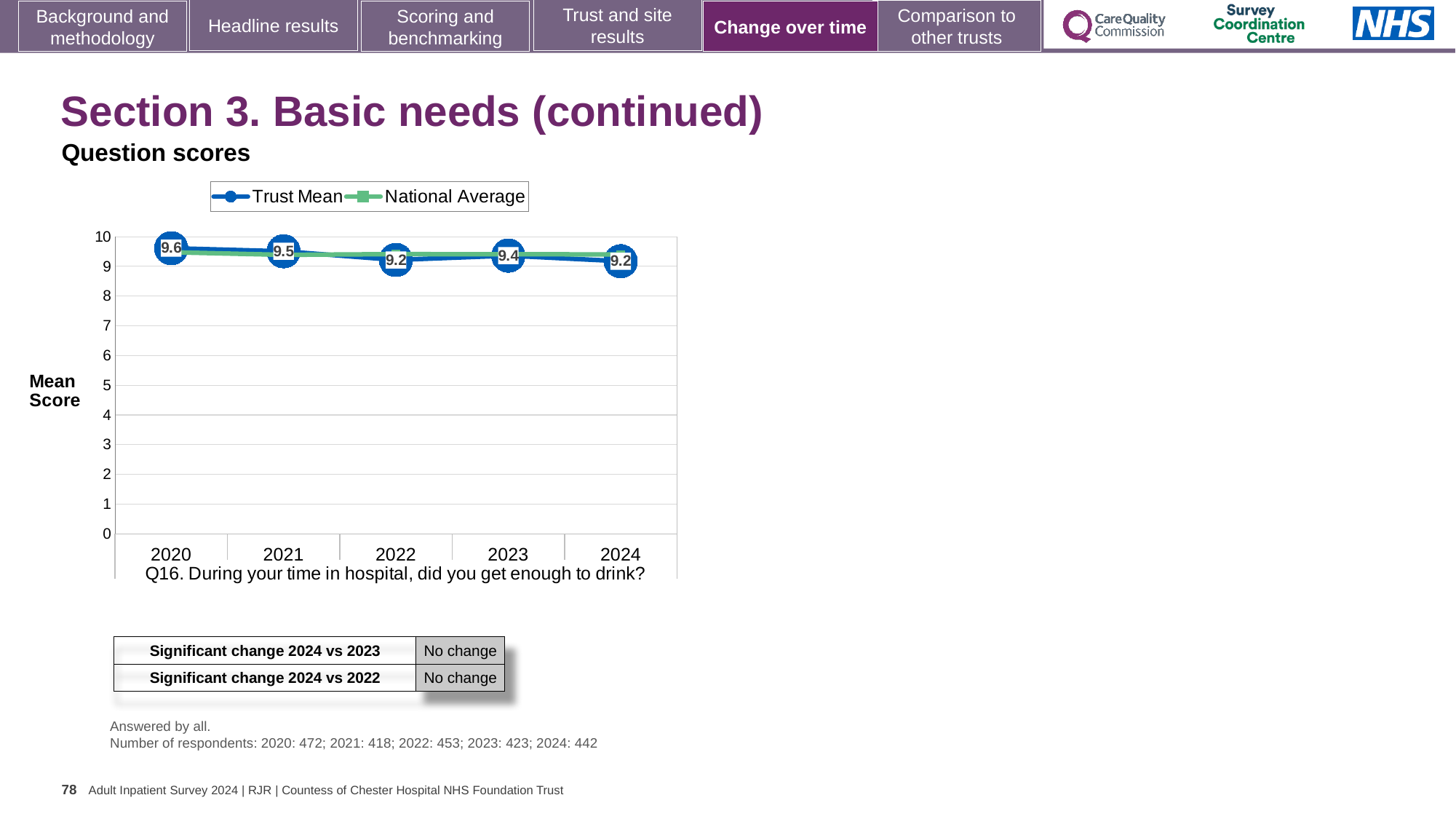
Which survey question does the chart relate to? Q16. During your time in hospital, did you get enough to drink? What is the Trust Mean score for 2022? 9.2 In which year is the Trust Mean score highest? 2020 What is the difference between the Trust Mean score in 2020 and in 2024? 0.4 How many years are shown on the x axis of the chart? 5 What is the Trust Mean score for 2020? 9.6 Is the National Average value for 2024 greater or less than 8? greater What kind of chart is shown on the slide? Line chart How many series does the chart legend list? 2 Does the Trust Mean score rise or fall overall from 2020 to 2024? Fall What is the Trust Mean score for 2024? 9.2 Which year has the larger Trust Mean score, 2021 or 2022? 2021